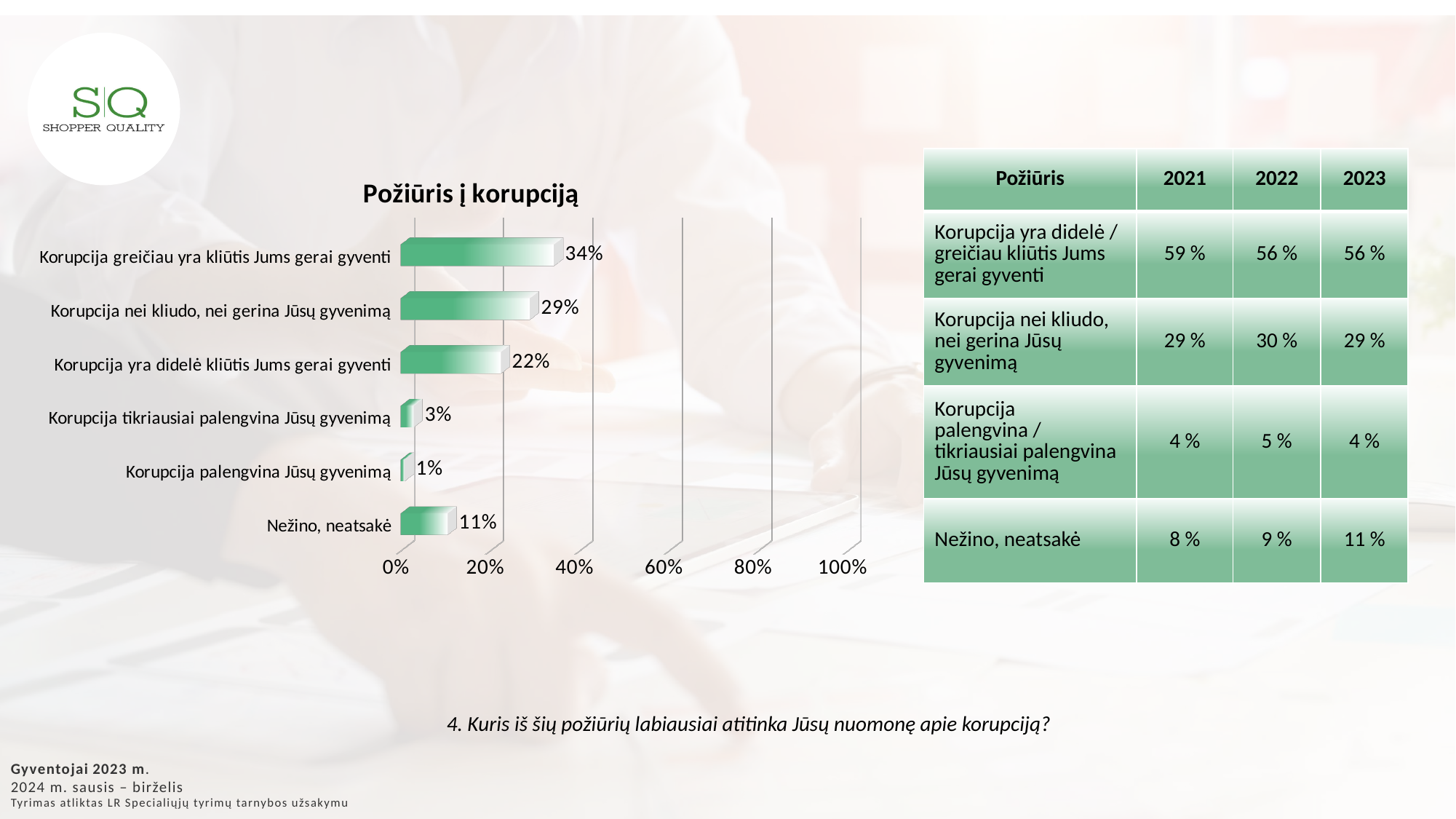
What is the difference between the values for "Korupcija greičiau yra kliūtis Jums gerai gyventi" and "Korupcija yra didelė kliūtis Jums gerai gyventi"? 12% What is the value for "Korupcija greičiau yra kliūtis Jums gerai gyventi" in the chart? 34% What kind of chart is shown on the slide? bar chart What is the value for "Korupcija tikriausiai palengvina Jūsų gyvenimą" in the chart? 3% What is the title of the chart? Požiūris į korupciją Is the value for "Korupcija nei kliudo, nei gerina Jūsų gyvenimą" greater or less than 20%? greater What is the value for "Korupcija nei kliudo, nei gerina Jūsų gyvenimą" in the chart? 29% How many categories are shown in the chart? 6 Which category has the highest value in the chart? Korupcija greičiau yra kliūtis Jums gerai gyventi What is the value for "Nežino, neatsakė" in the chart? 11% Which is larger: the value for "Korupcija tikriausiai palengvina Jūsų gyvenimą" or for "Nežino, neatsakė"? Nežino, neatsakė Which category has the lowest value in the chart? Korupcija palengvina Jūsų gyvenimą